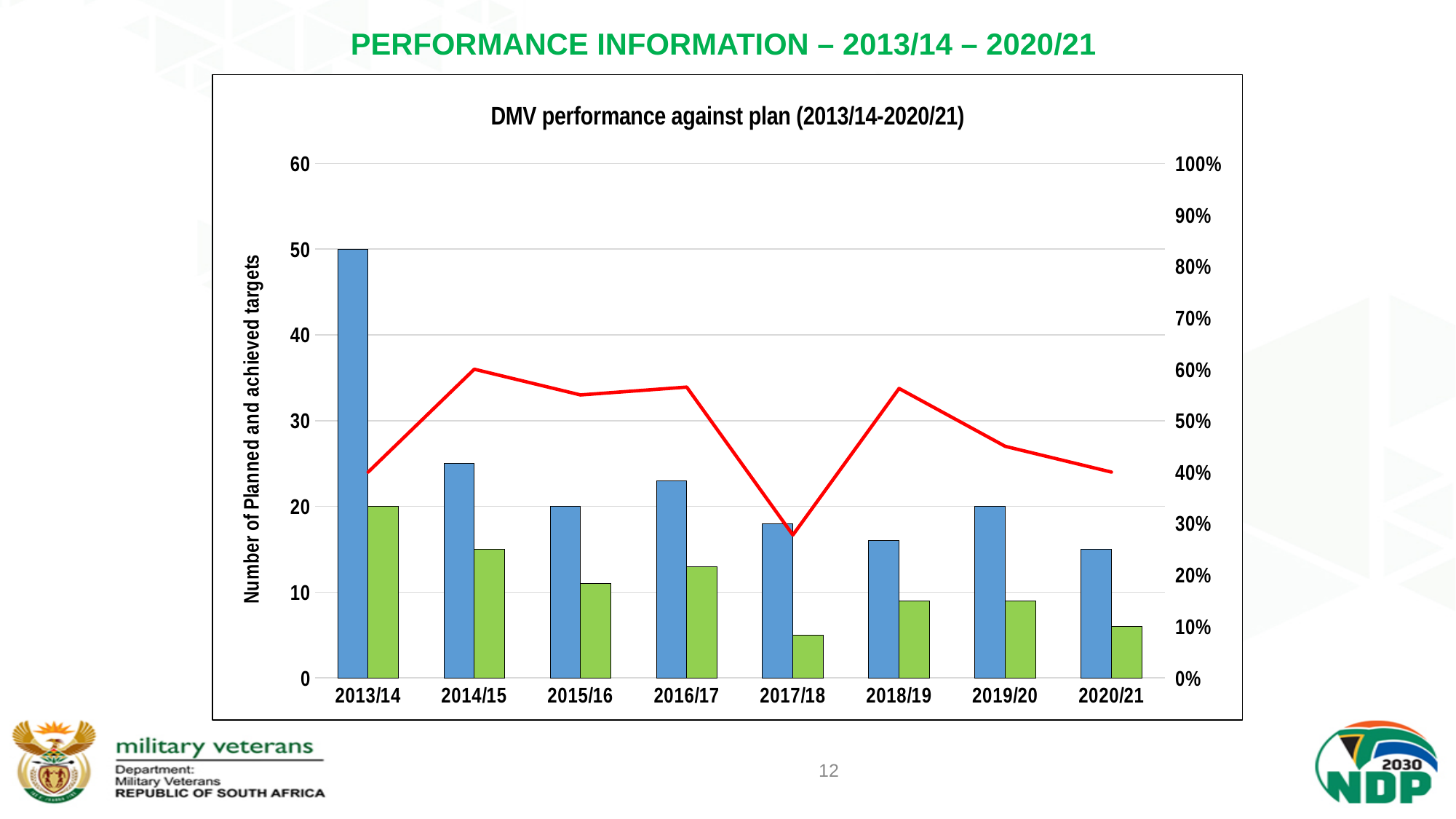
In which year is the green bar the shortest? 2017/18 Is the red line value for 2017/18 greater or less than 30%? less What is the label of the left vertical axis? Number of Planned and achieved targets Which is larger, the blue bar for 2016/17 or the blue bar for 2018/19? 2016/17 How many financial years are shown along the x axis of the chart? 8 Is the value of the blue bar for 2014/15 greater or less than 20? greater What is the title of the chart? DMV performance against plan (2013/14-2020/21) What is the value of the blue bar for 2013/14? 50 Is the value of the green bar for 2017/18 greater or less than 10? less What type of chart is shown on the slide? Combination bar and line chart What is the value of the green bar for 2013/14? 20 In which year is the blue bar the tallest? 2013/14